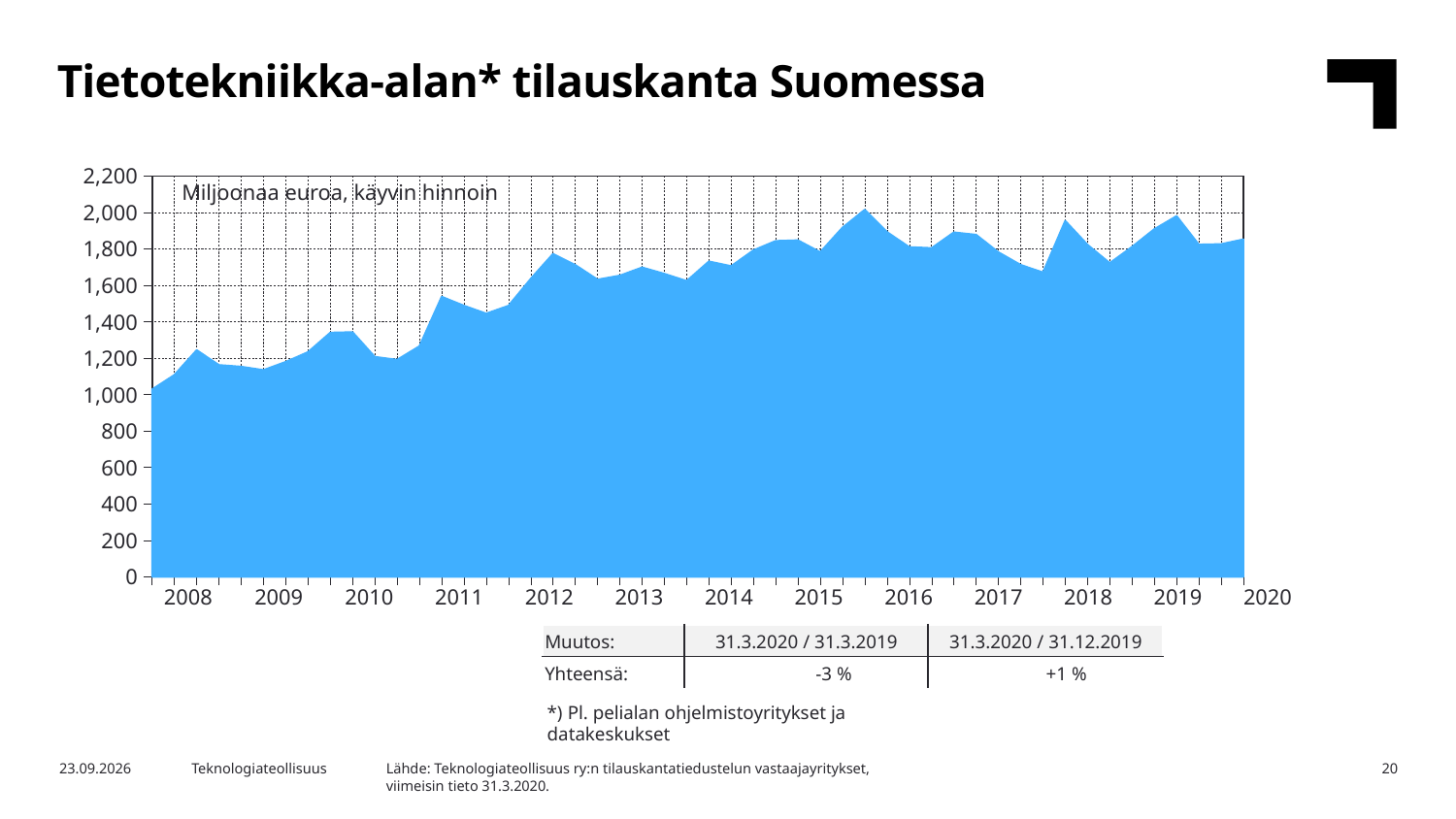
Overall, do the values rise or fall from 2008 to 2020? rise Is the value at the 2012 tick greater or less than 1,600? greater What kind of chart is shown on the slide? area chart What unit is stated in the label inside the chart area? Miljoonaa euroa, käyvin hinnoin How many year labels are shown on the x axis? 13 Is the value at the 2020 tick greater or less than 1,600? greater Is the value at the 2011 tick greater or less than 1,400? greater What is the title of the chart? Tietotekniikka-alan* tilauskanta Suomessa In which year does the series reach its lowest value? 2008